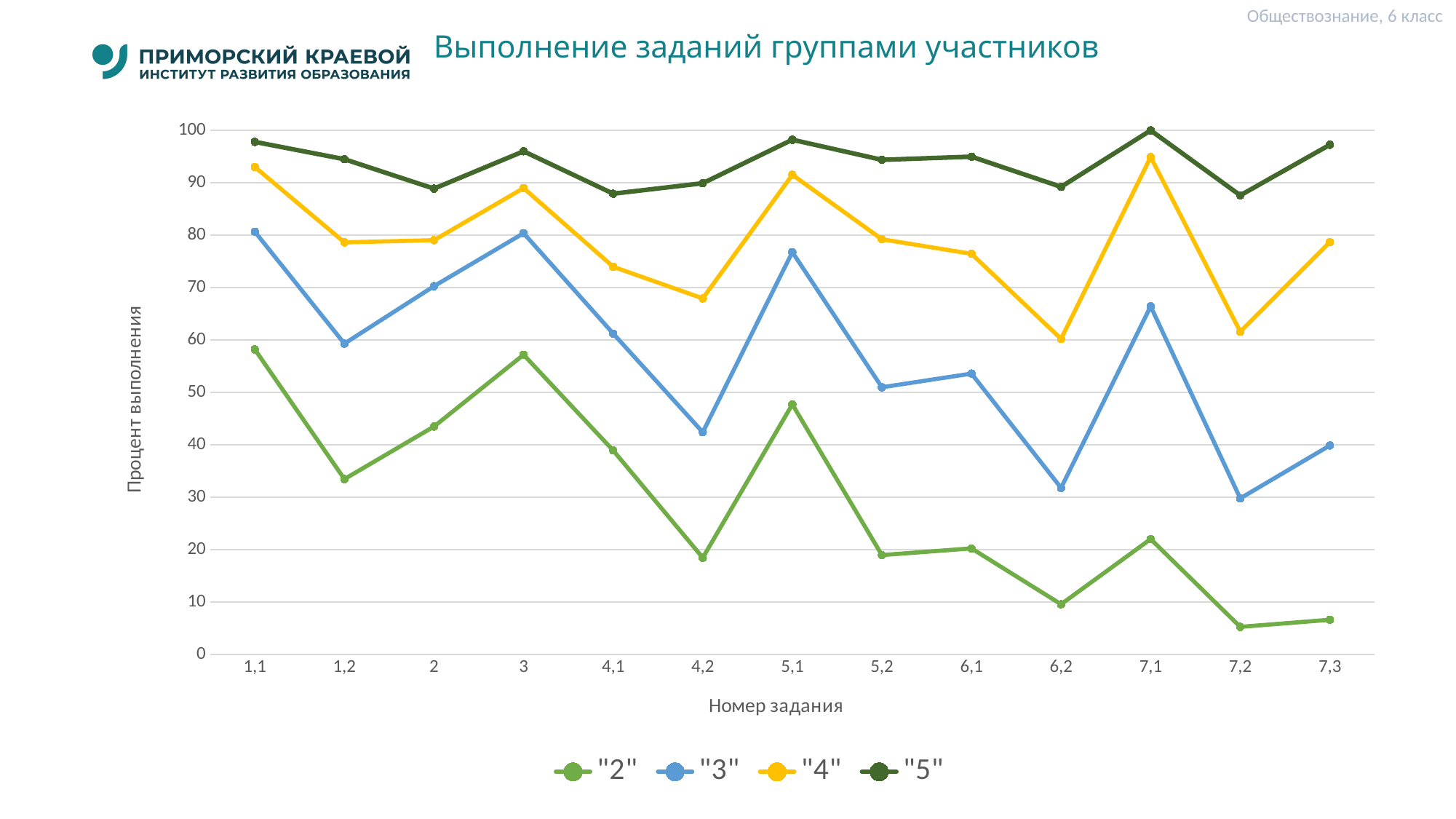
What is the title of the x axis? Номер задания Is the value for series "5" at task 2 greater or less than 80? greater Is the value for series "2" at task 7,2 greater or less than 10? less For series "2", which is larger: the value at task 1,1 or at task 4,2? 1,1 Does the line for series "2" rise or fall from task 3 to task 4,2? fall Is the value for series "4" at task 7,1 greater or less than 90? greater How many task numbers are shown along the x axis? 13 For series "3", which is larger: the value at task 5,1 or at task 6,2? 5,1 For series "2", at which task number is the value lowest? 7,2 What kind of chart is shown on the slide? line chart How many series does the legend list? 4